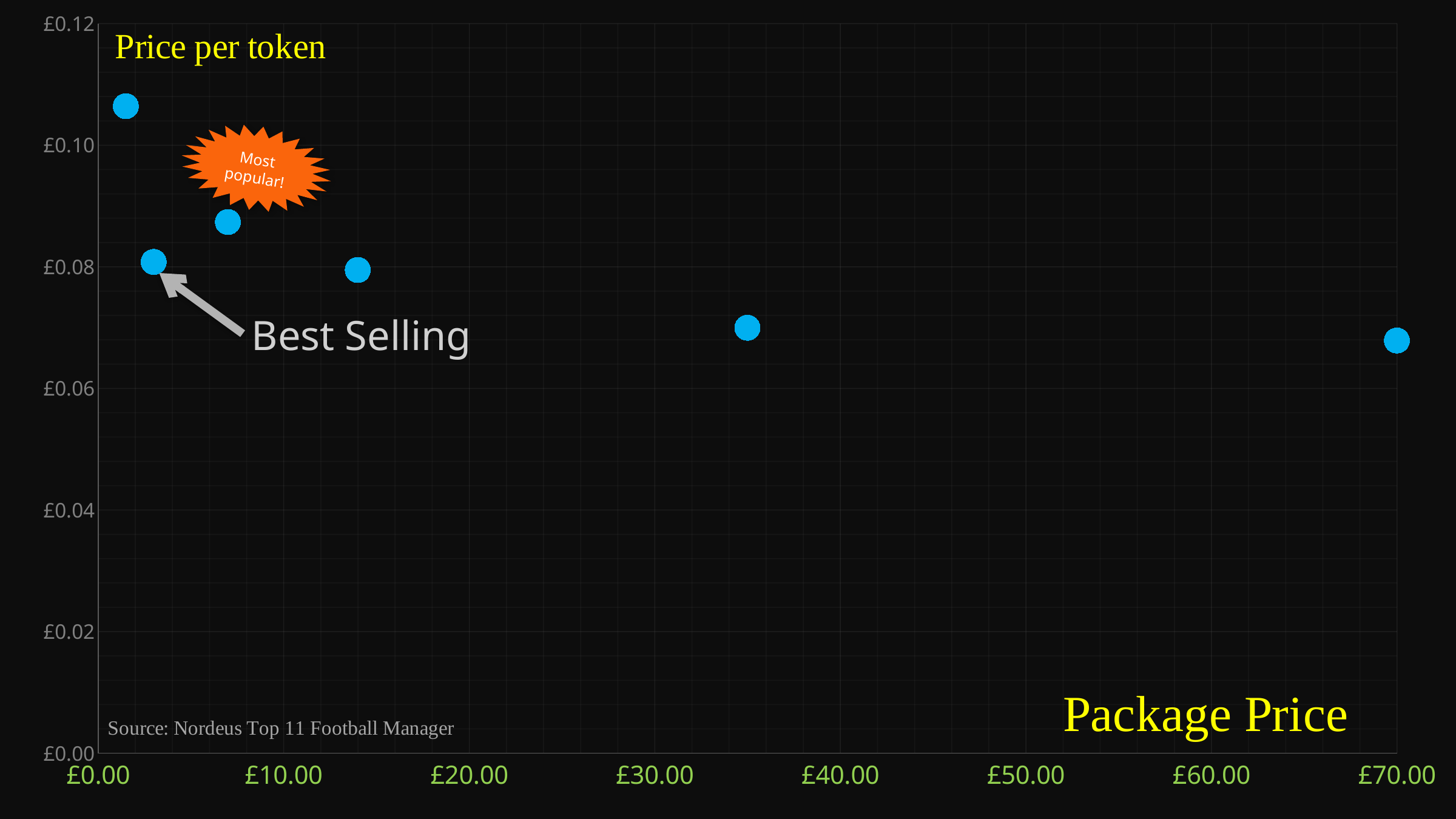
Is the price per token for the point at the highest package price (around £70.00) greater or less than £0.08? less Is the price per token for the point at a package price of about £35.00 greater or less than £0.08? less Is the price per token for the point marked 'Best Selling' greater or less than £0.10? less What is the label of the horizontal axis? Package Price Which point has the highest price per token: the one at the lowest package price or the one at the highest package price? The one at the lowest package price Which has the higher price per token: the 'Most popular!' point or the 'Best Selling' point? Most popular! Does the price per token generally rise or fall as the package price increases? Fall What kind of chart is shown on the slide? Scatter chart How many data points are plotted on the chart? 6 What is the label of the vertical axis? Price per token